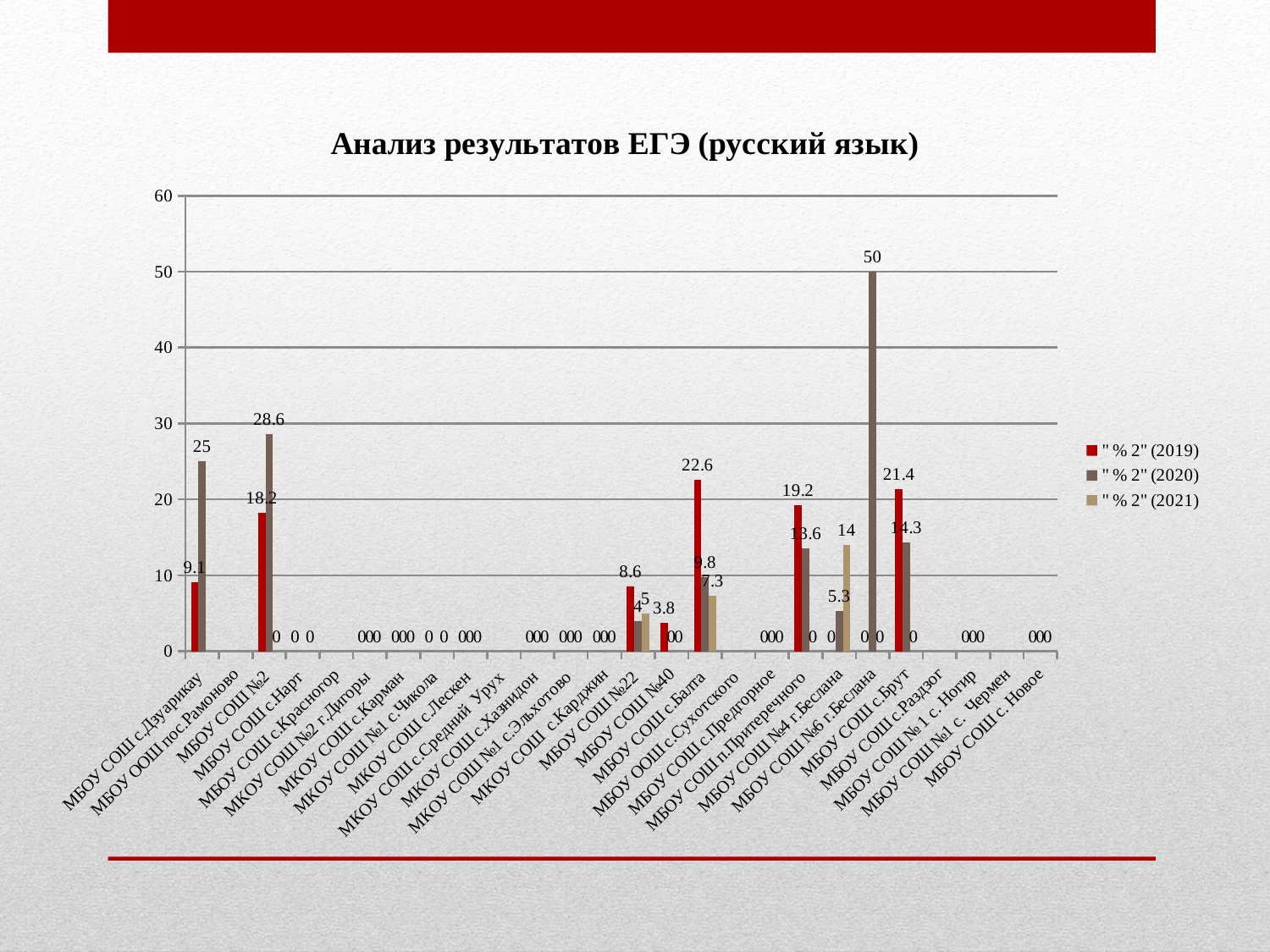
Is the 2020 value for МБОУ СОШ №6 г.Беслана greater or less than 40? greater What is the value for МБОУ СОШ с.Брут in the " % 2" (2020) series? 14.3 Which is larger for МБОУ СОШ с.Дзуарикау: the 2019 value or the 2020 value? 2020 What is the value for МБОУ СОШ с.Дзуарикау in the " % 2" (2020) series? 25 Which school has the highest value in the " % 2" (2019) series? МБОУ СОШ с.Балта How many schools (categories) are shown on the x axis? 26 What kind of chart is shown on the slide? bar chart How many series does the legend list? 3 Which school has the highest value in the " % 2" (2020) series? МБОУ СОШ №6 г.Беслана What is the value for МБОУ СОШ №2 in the " % 2" (2019) series? 18.2 What is the title of the chart? Анализ результатов ЕГЭ (русский язык) What is the difference between the 2020 and 2019 values for МБОУ СОШ №2? 10.4